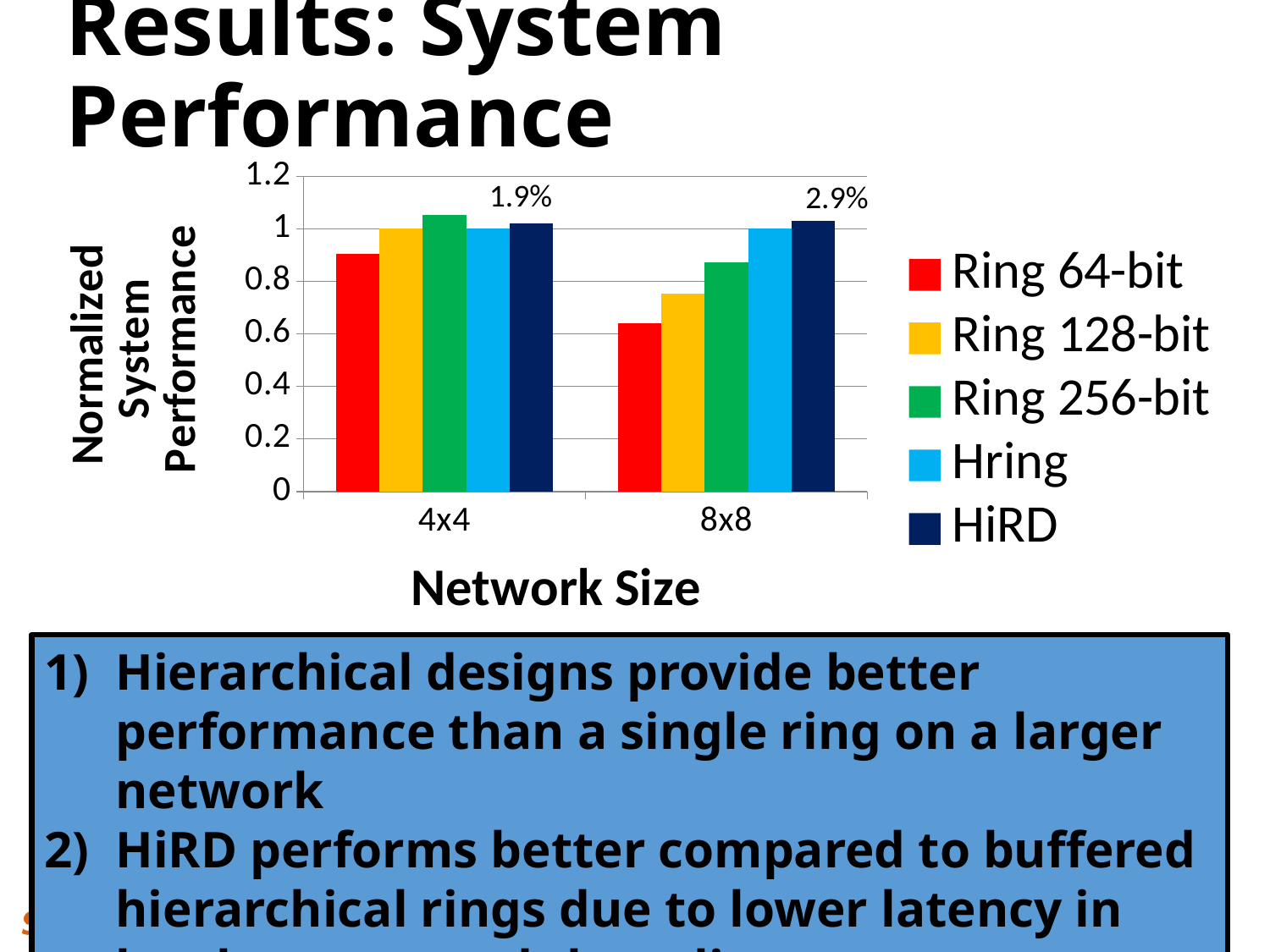
Is the normalized system performance for Ring 64-bit at 8x8 greater or less than 0.8? less Is the normalized system performance for Ring 64-bit at 4x4 greater or less than 0.8? greater What percentage label is printed above the HiRD bar for network size 8x8? 2.9% What kind of chart is shown on the slide? bar chart How many network sizes are shown on the x axis of the chart? 2 What is the normalized system performance of Hring at network size 8x8? 1 At network size 8x8, which has higher normalized system performance: Ring 64-bit or Ring 256-bit? Ring 256-bit Which series has the lowest normalized system performance at network size 8x8? Ring 64-bit Is the normalized system performance for Ring 256-bit at 8x8 greater or less than 0.8? greater How many series does the chart legend list? 5 What is the label of the x axis of the chart? Network Size Does the normalized system performance of Ring 64-bit rise or fall from 4x4 to 8x8? fall